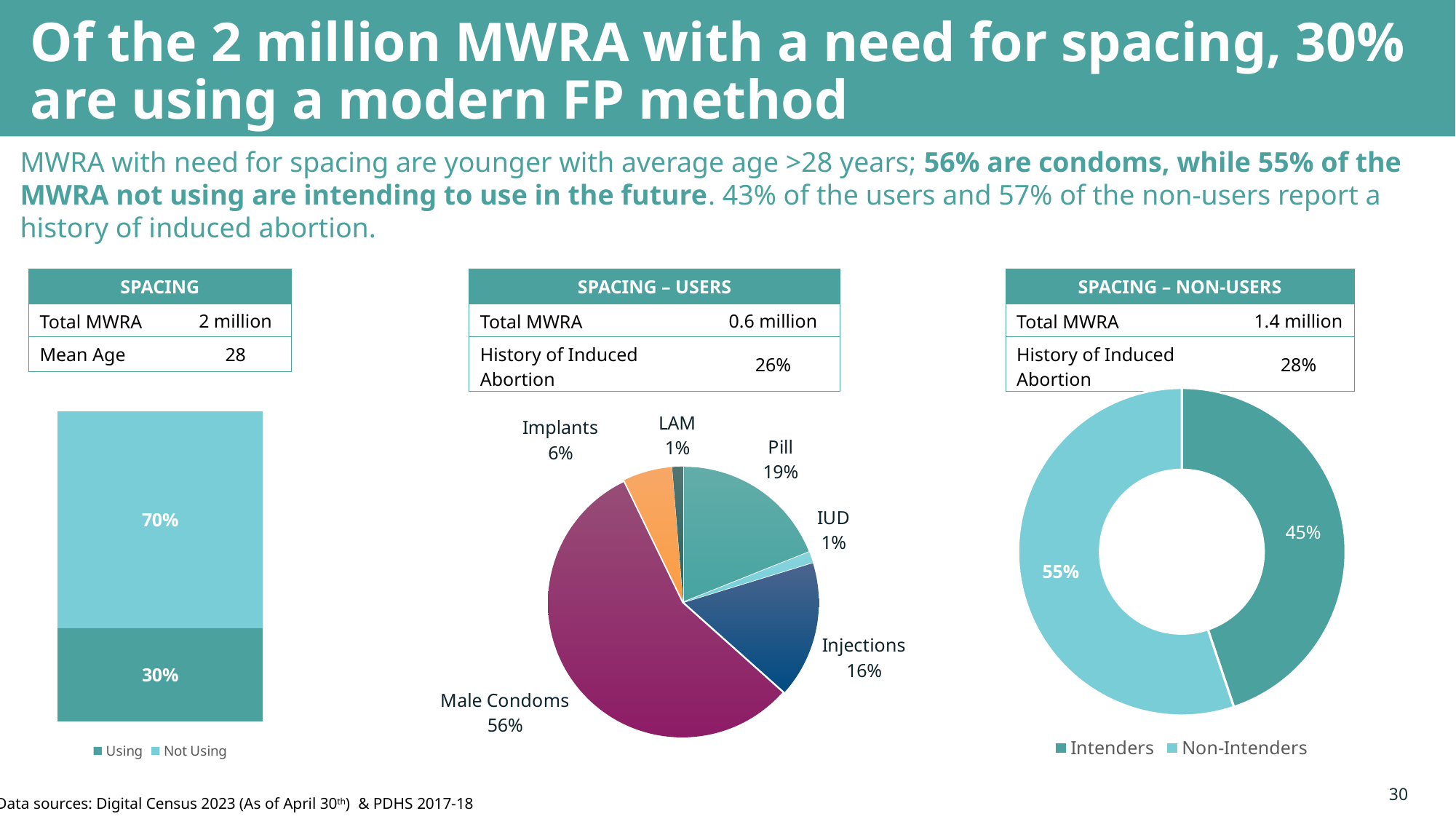
In the pie chart in the middle, which is larger, Implants or Pill? Pill In the pie chart in the middle, how many method categories are shown? 6 In the pie chart in the middle, what is the difference between the Pill share and the Injections share? 3% In the pie chart in the middle, which method has the largest share? Male Condoms In the pie chart in the middle, what percentage is shown for Injections? 16% In the donut chart on the right, which category has the larger share? Non-Intenders In the stacked bar chart on the left, what is the total of the two segments? 100% In the donut chart on the right, what percentage is shown for Intenders? 45% In the stacked bar chart on the left, what percentage is shown for Not Using? 70% What type of chart is the chart on the left of the slide? Stacked bar chart In the stacked bar chart on the left, what percentage is shown for Using? 30% In the pie chart in the middle, what share is Male Condoms? 56%